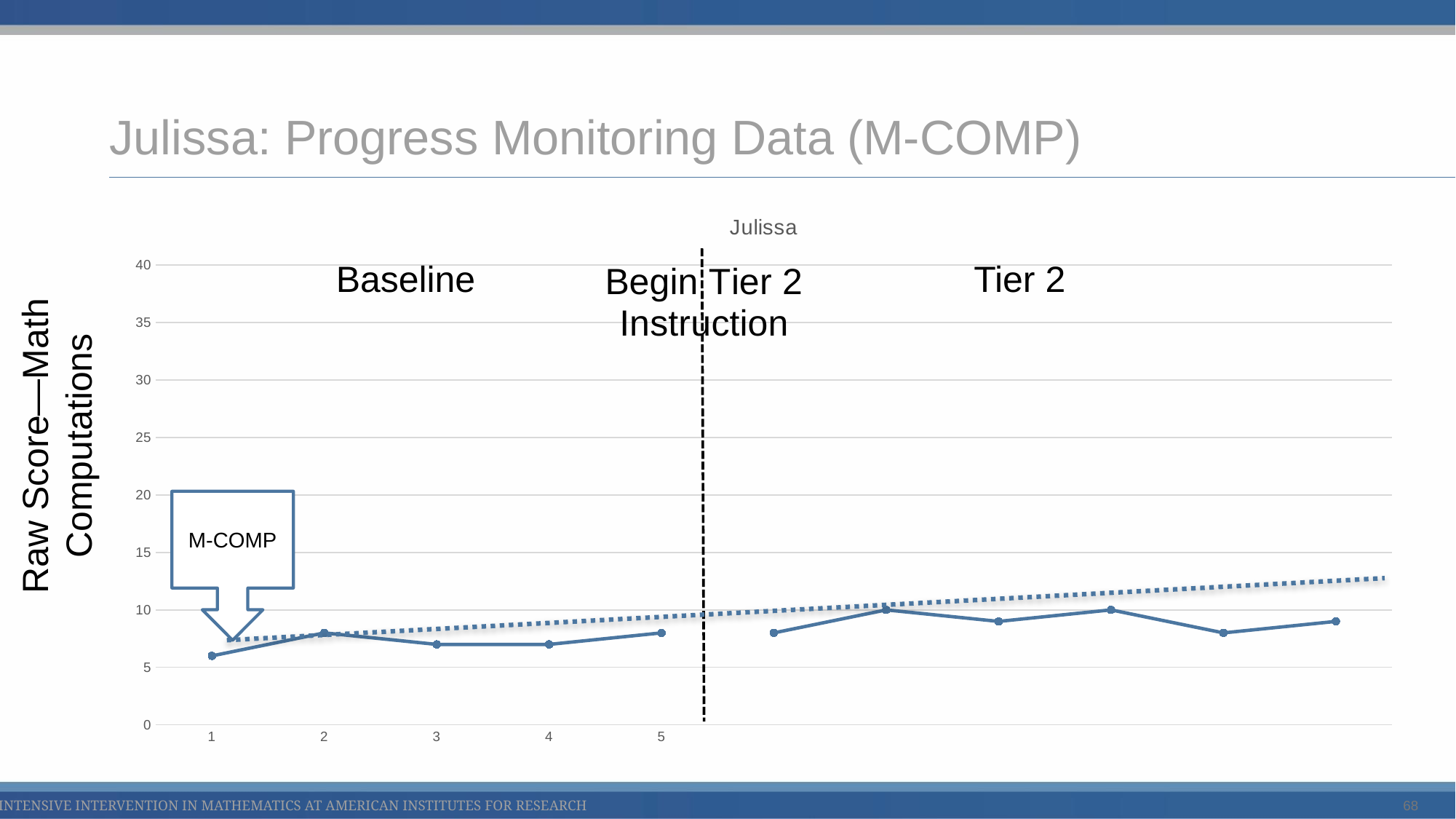
What is the highest value shown on the y axis? 40 Is the value at x = 1 greater or less than 10? less What kind of chart is shown on the slide? line chart Is the value at x = 3 greater or less than 10? less Does the dotted trend line rise or fall from left to right? rise What is the title of the chart? Julissa Is the value at x = 5 greater or less than 10? less What is the label on the vertical axis of the chart? Raw Score—Math Computations How many data points are plotted on the line? 11 How many numbered tick labels appear on the x axis? 5